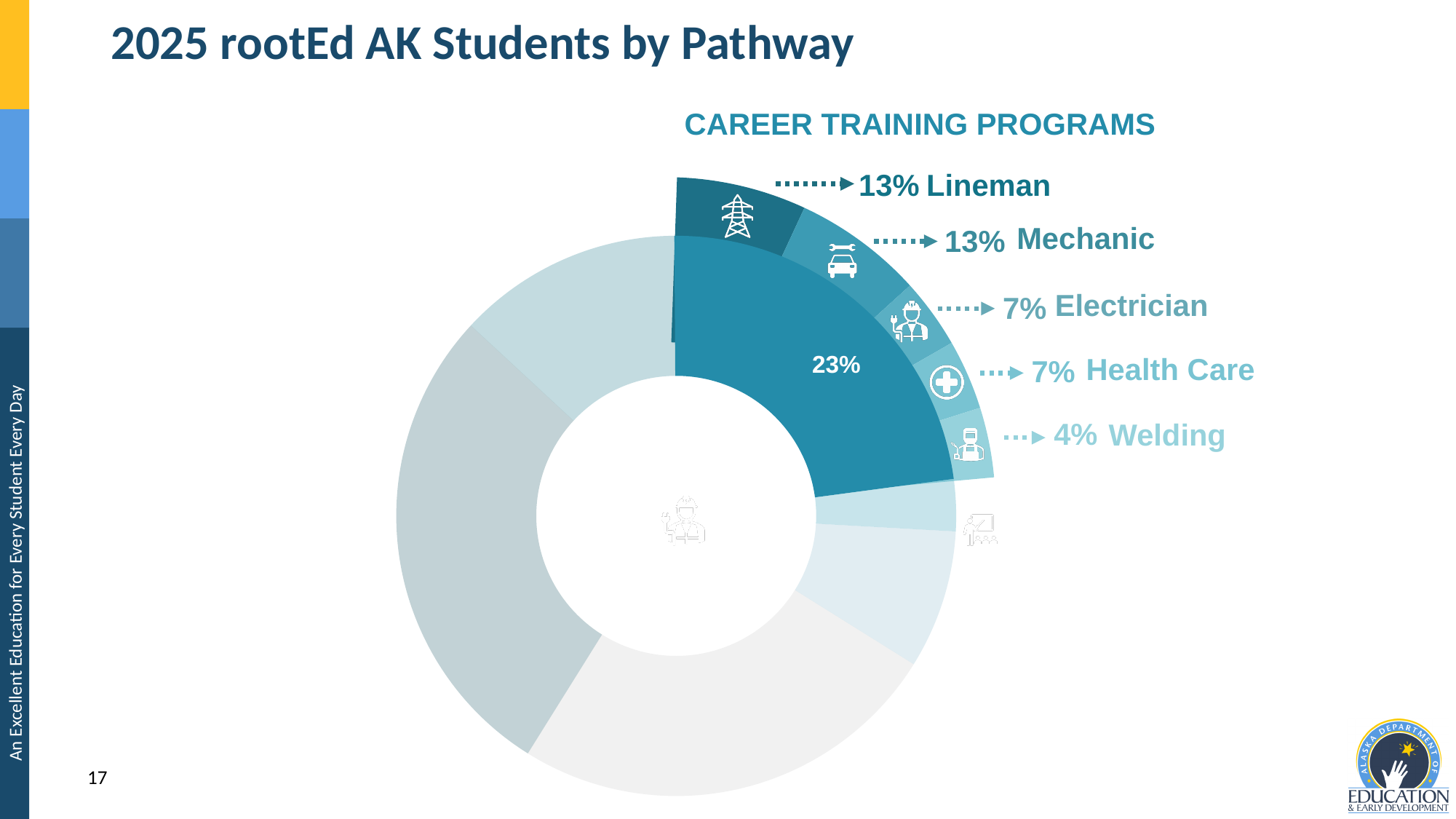
Which has a larger percentage, Electrician or Welding? Electrician What percentage is shown for Electrician? 7% What kind of chart is shown on the slide? pie chart (donut) What is the title of the slide? 2025 rootEd AK Students by Pathway What percentage is shown for Welding? 4% What percentage is shown for Lineman? 13% How many career training programs are labeled with percentages on the chart? 5 What percentage is shown for Mechanic? 13% What is the difference between the Lineman percentage and the Welding percentage? 9% What percentage is shown for Health Care? 7% Which of the labeled career training programs has the lowest percentage? Welding What percentage is shown for the Career Training Programs segment of the chart? 23%